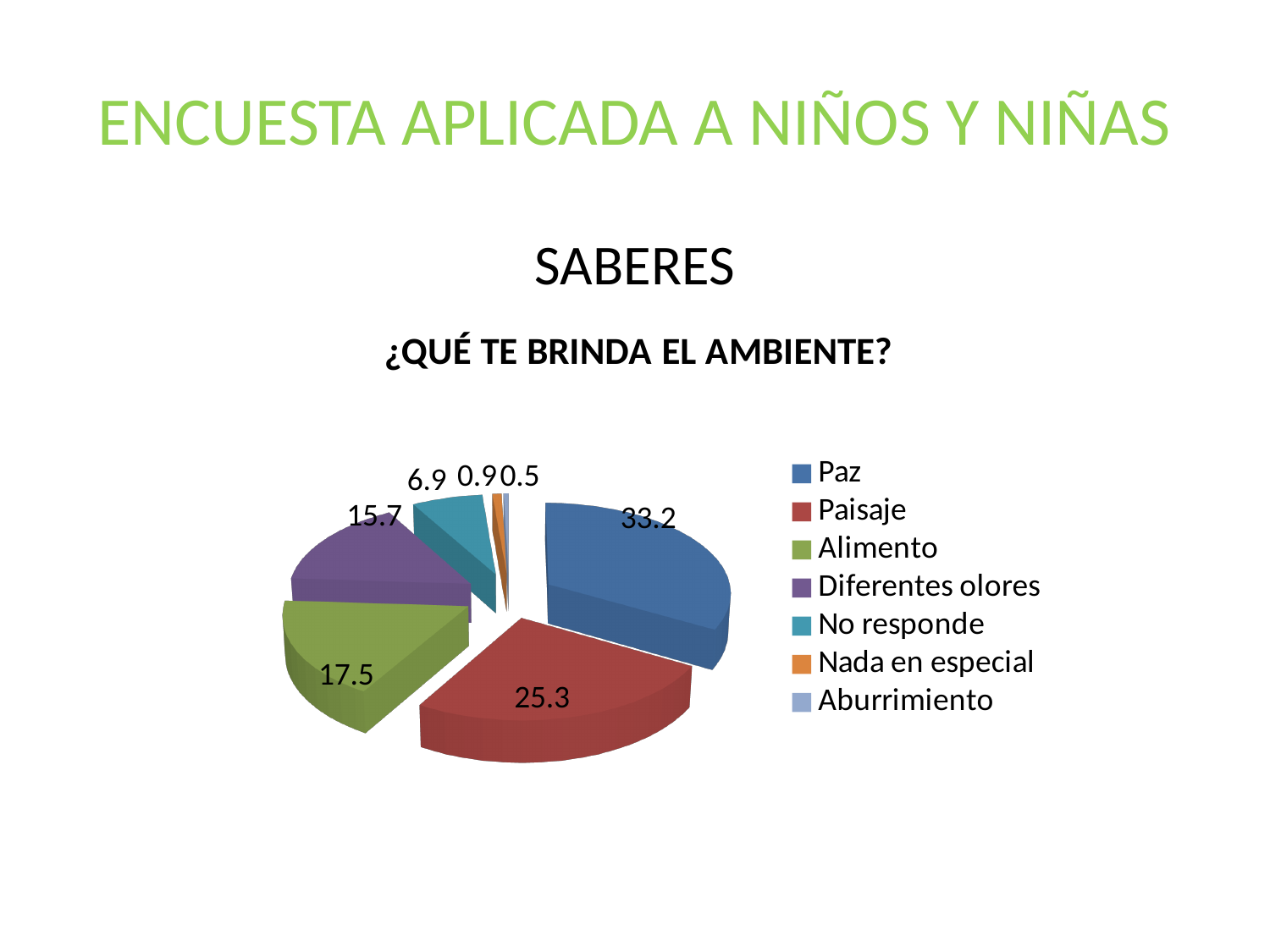
What is the value for No responde? 6.9 Which is larger, the value for Alimento or the value for Diferentes olores? Alimento What is the difference between the values for Paz and Paisaje? 7.9 Which category has the largest slice? Paz What is the title of the chart? ¿QUÉ TE BRINDA EL AMBIENTE? What is the value for Diferentes olores? 15.7 What is the value for Paisaje? 25.3 Which category has the smallest slice? Aburrimiento What is the value for Alimento? 17.5 What kind of chart is shown on the slide? pie chart How many categories does the legend list? 7 What is the value for Paz? 33.2